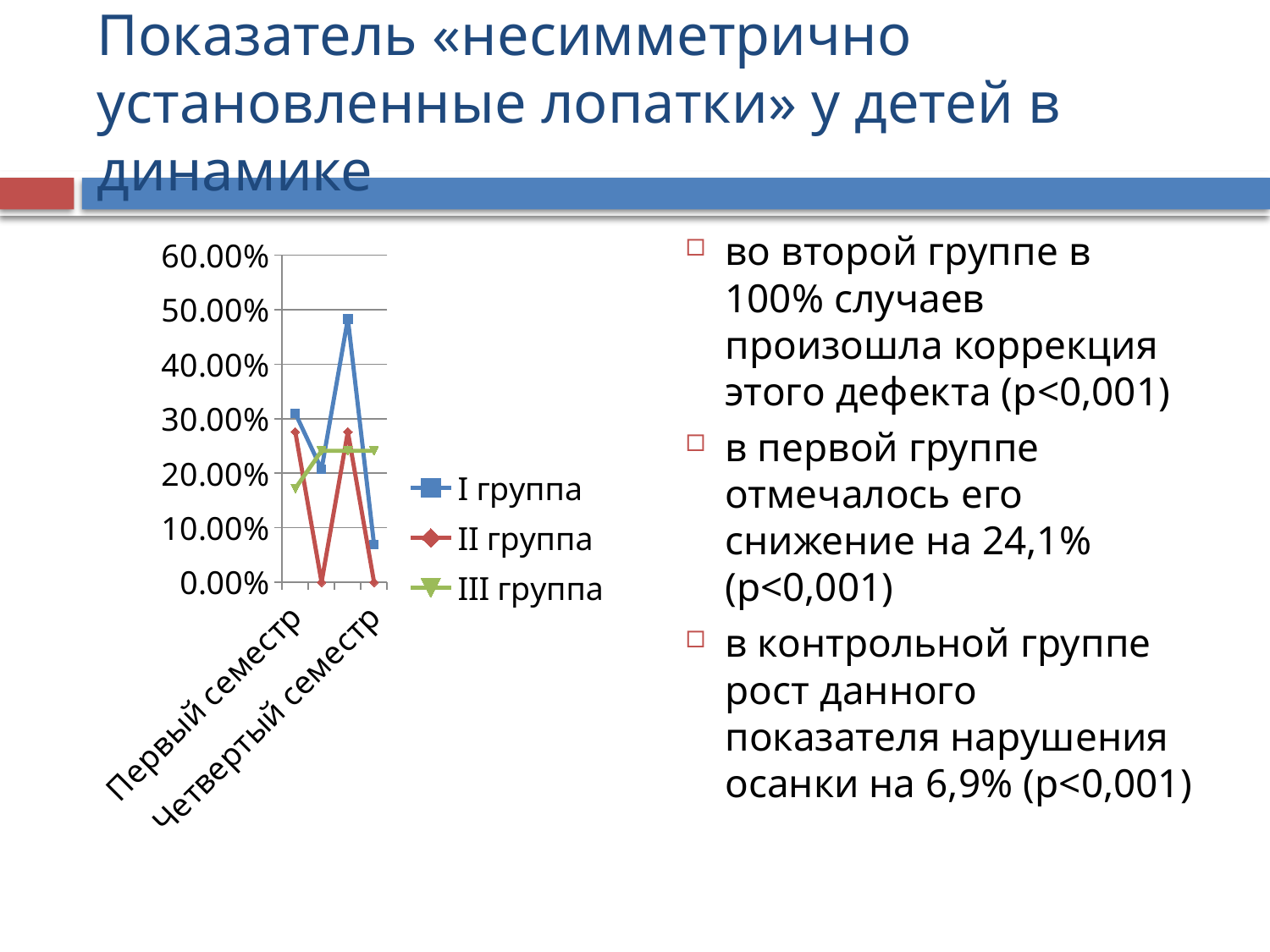
What is the lowest value reached by the II группа series? 0.00% Is the value for I группа at Первый семестр greater or less than 20.00%? greater Which series reaches the highest value on the chart? I группа Is the value for III группа at Первый семестр greater or less than 20.00%? less What is the highest value shown on the chart's vertical axis? 60.00% At Четвертый семестр, which series has the larger value, I группа or III группа? III группа What are the series names listed in the chart legend? I группа, II группа, III группа Is the value for I группа at Четвертый семестр greater or less than 10.00%? less What kind of chart is shown on the slide? line chart Does the I группа series rise or fall from Первый семестр to Четвертый семестр? fall Does the III группа series rise or fall from Первый семестр to Четвертый семестр? rise How many series does the chart legend list? 3